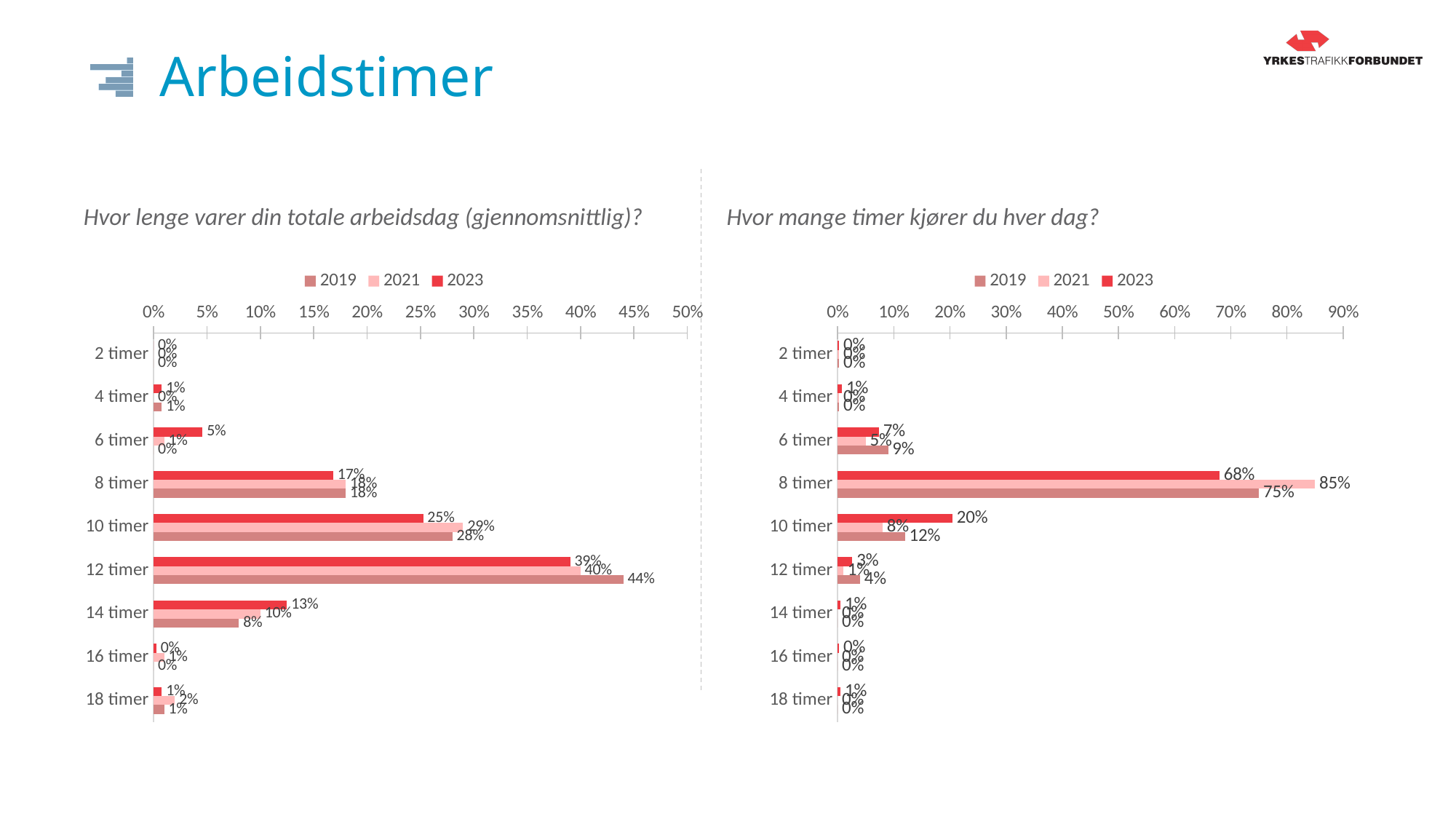
How many categories are shown on the y axis of the chart 'Hvor mange timer kjører du hver dag?'? 9 In the chart 'Hvor mange timer kjører du hver dag?', what is the 2023 value for 10 timer? 20% In the chart 'Hvor lenge varer din totale arbeidsdag (gjennomsnittlig)?', what is the difference between the 2021 and 2023 values for 10 timer? 4% In the chart 'Hvor mange timer kjører du hver dag?', what is the 2021 value for 8 timer? 85% In the chart 'Hvor mange timer kjører du hver dag?', is the 2023 value for 8 timer greater or less than 60%? greater In the chart 'Hvor mange timer kjører du hver dag?', what is the difference between the 2021 and 2019 values for 8 timer? 10% In the chart 'Hvor mange timer kjører du hver dag?', which is larger for 6 timer: the 2019 value or the 2023 value? 2019 How many series does the legend of the chart 'Hvor lenge varer din totale arbeidsdag (gjennomsnittlig)?' list? 3 In the chart 'Hvor lenge varer din totale arbeidsdag (gjennomsnittlig)?', which category has the highest 2023 value? 12 timer In the chart 'Hvor lenge varer din totale arbeidsdag (gjennomsnittlig)?', what is the 2019 value for 12 timer? 44% In the chart 'Hvor lenge varer din totale arbeidsdag (gjennomsnittlig)?', what is the 2023 value for 14 timer? 13% What type of chart is the chart 'Hvor mange timer kjører du hver dag?'? Bar chart